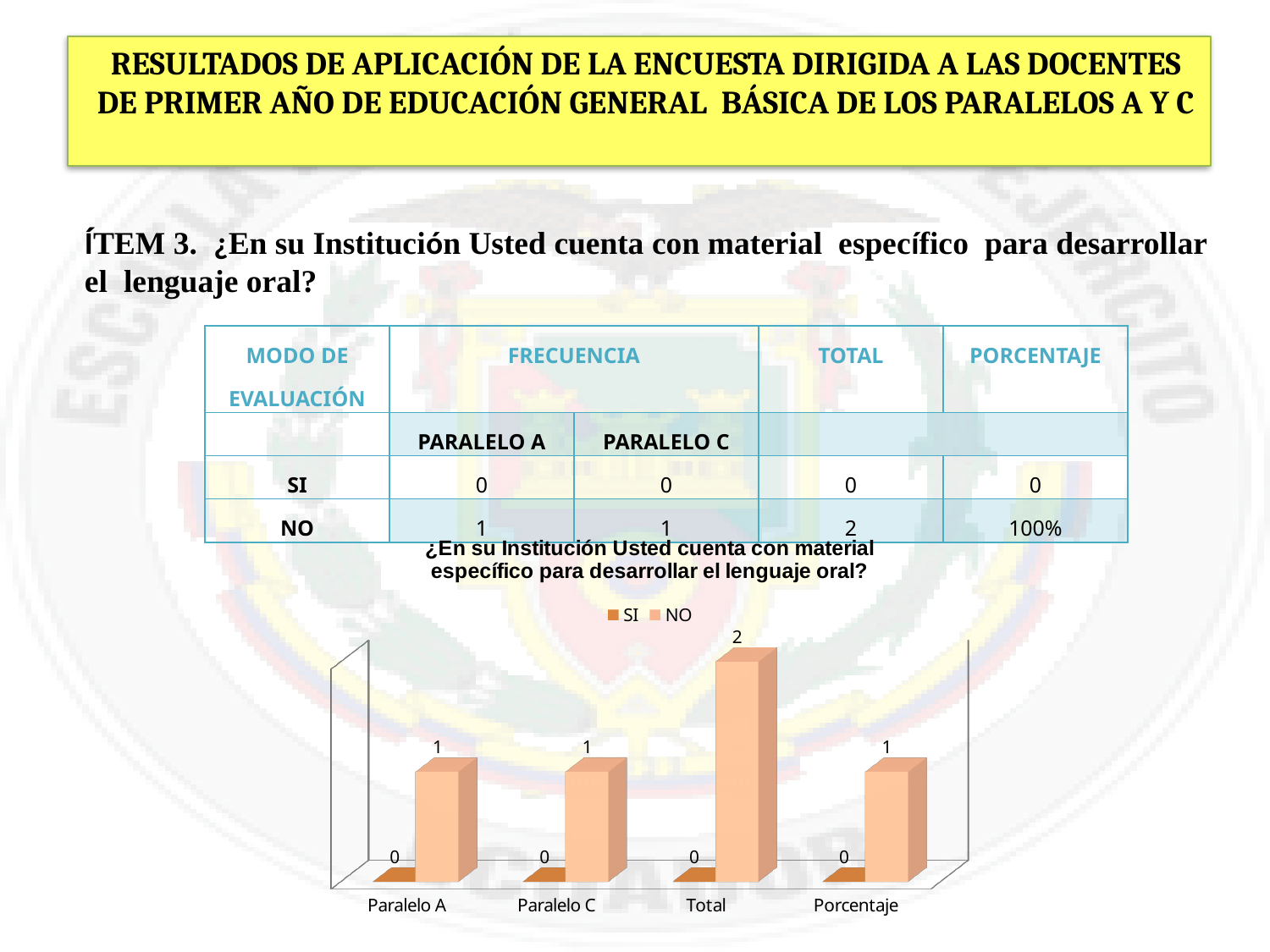
What is the value of the NO series for Paralelo A in the chart? 1 What is the title of the chart? ¿En su Institución Usted cuenta con material específico para desarrollar el lenguaje oral? What kind of chart is shown on the slide? Bar chart What is the value of the SI series for Paralelo C in the chart? 0 Which is larger for Paralelo C: the SI value or the NO value? NO How many series does the chart legend list? 2 What is the difference between the NO value for Total and the NO value for Paralelo A? 1 How many categories are shown on the x axis of the chart? 4 What is the value of the NO series for Total in the chart? 2 What are the two series named in the chart legend? SI and NO Which category has the highest NO value in the chart? Total What is the value of the NO series for Porcentaje in the chart? 1